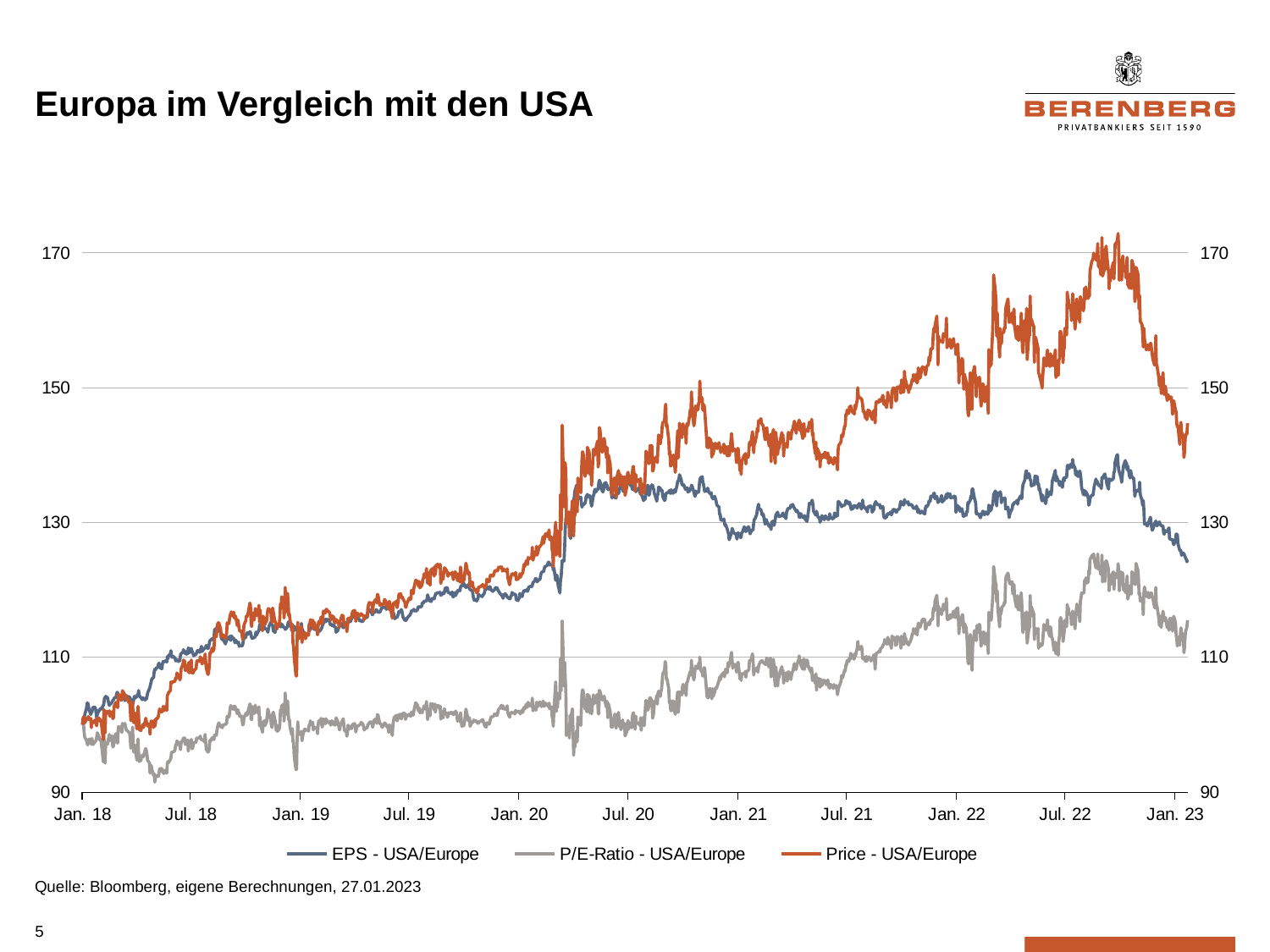
Which series does the legend show in orange? Price - USA/Europe Is the value of P/E-Ratio - USA/Europe at Jan. 18 greater or less than 110? less Is the value of P/E-Ratio - USA/Europe at Jan. 23 greater or less than 130? less What is the title of the slide containing the chart? Europa im Vergleich mit den USA Is the value of Price - USA/Europe at Jan. 23 greater or less than 130? greater What kind of chart is shown on the slide? line chart Which series has the lowest value at Jan. 23? P/E-Ratio - USA/Europe Which series reaches the highest value anywhere on the chart? Price - USA/Europe Does Price - USA/Europe rise or fall overall from Jan. 18 to Jan. 23? rise At Jan. 23, which is larger: Price - USA/Europe or P/E-Ratio - USA/Europe? Price - USA/Europe How many series does the legend list? 3